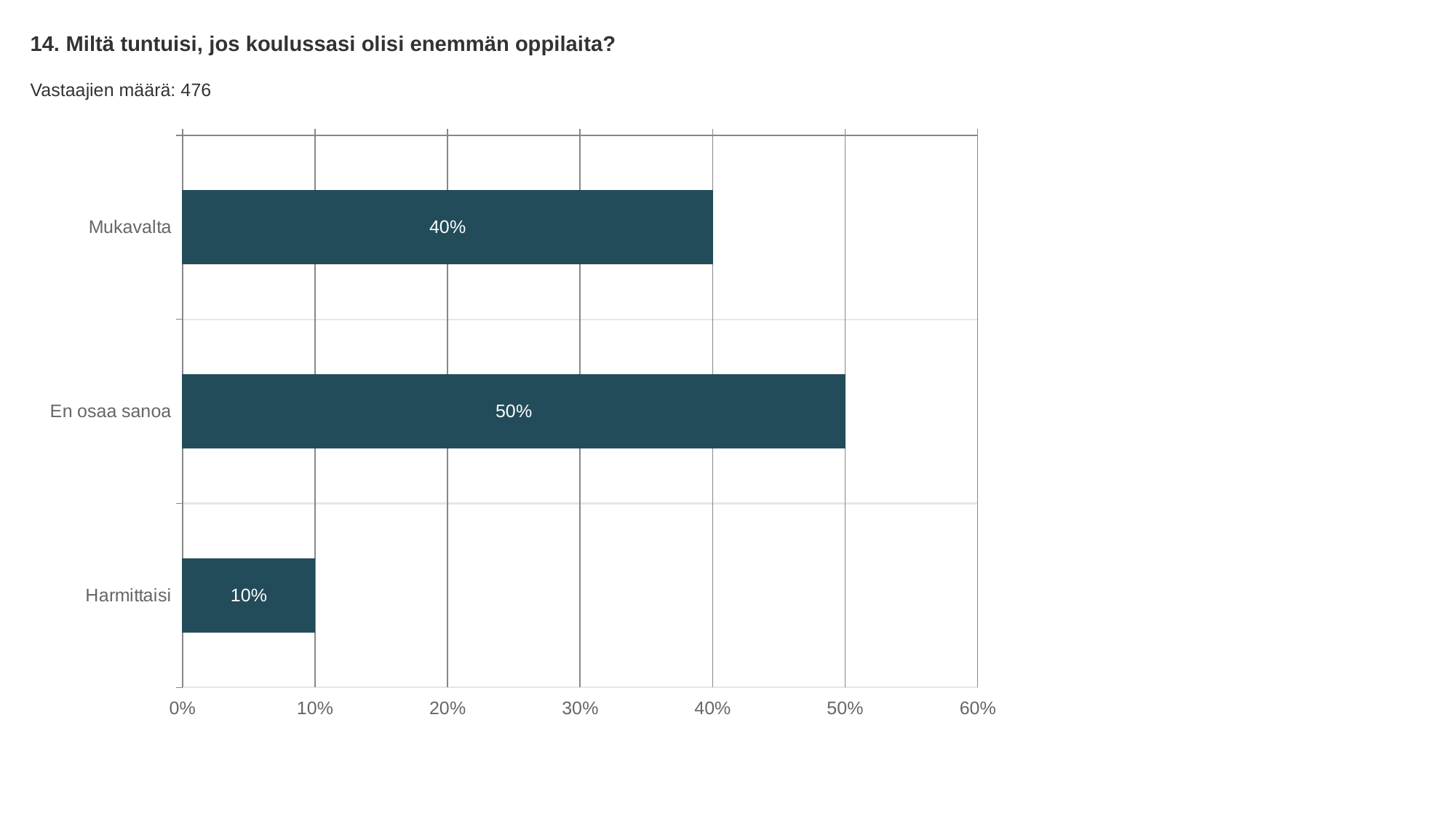
Which is larger, the value for Mukavalta or the value for Harmittaisi? Mukavalta Is the value for En osaa sanoa greater or less than 30%? greater What is the value for Harmittaisi? 10% How many categories are shown in the chart? 3 What is the difference between the values for Mukavalta and Harmittaisi? 30% Which category has the highest value? En osaa sanoa How many respondents (Vastaajien määrä) are reported on the slide? 476 What is the difference between the values for En osaa sanoa and Mukavalta? 10% What is the value for En osaa sanoa? 50% Which category has the lowest value? Harmittaisi What is the value for Mukavalta? 40% What kind of chart is shown on the slide? Bar chart